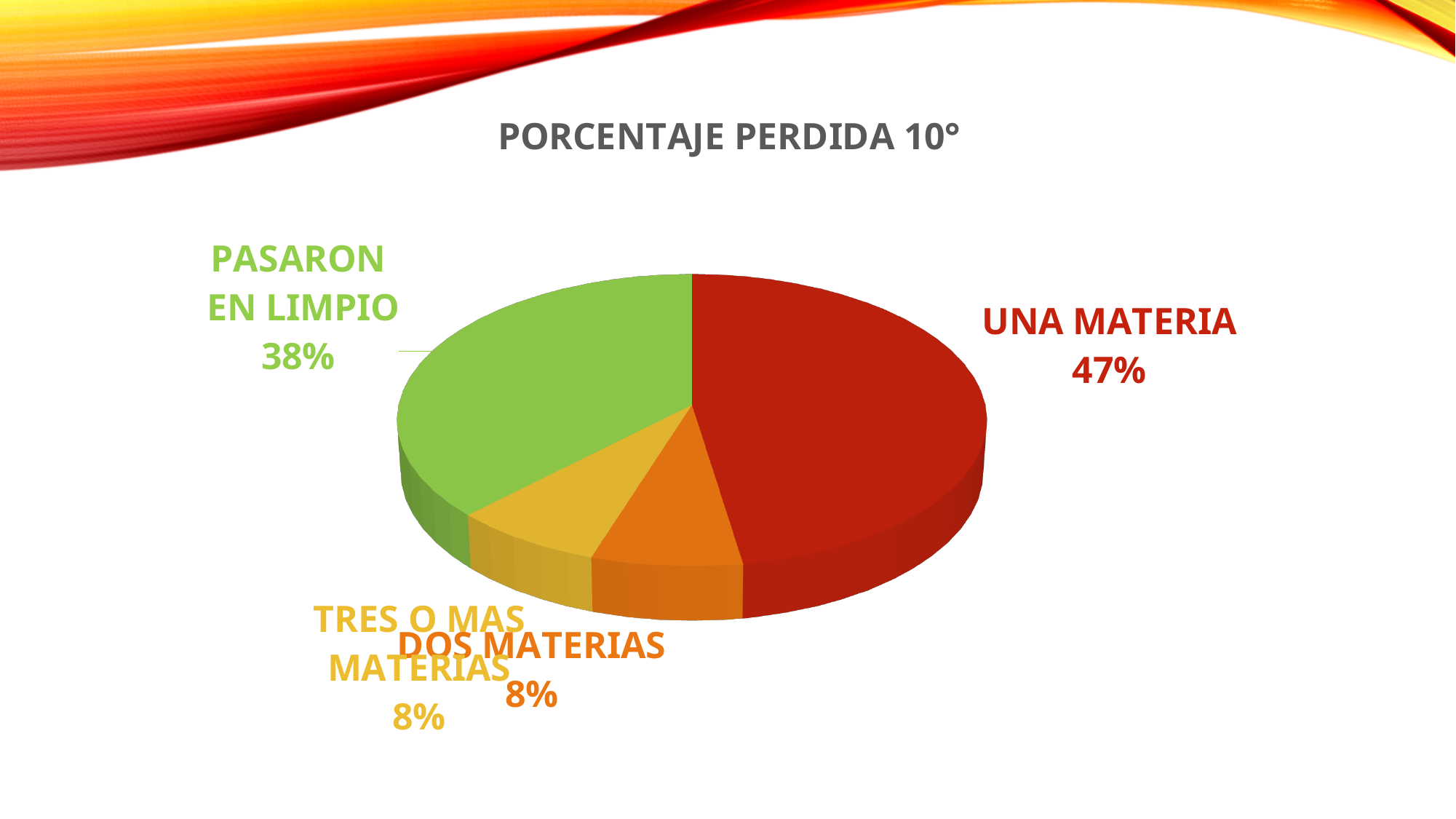
What percentage is shown for UNA MATERIA? 47% What is the title of the chart? PORCENTAJE PERDIDA 10° How many slices does the pie chart have? 4 Which category has the largest share of the pie? UNA MATERIA Which is larger, the share for PASARON EN LIMPIO or the share for DOS MATERIAS? PASARON EN LIMPIO What percentage is shown for PASARON EN LIMPIO? 38% What is the combined share of DOS MATERIAS and TRES O MAS MATERIAS? 16% What colour is the UNA MATERIA slice? red What is the difference in percentage points between UNA MATERIA and PASARON EN LIMPIO? 9 What type of chart is shown on the slide? pie chart What percentage is shown for TRES O MAS MATERIAS? 8% What percentage is shown for DOS MATERIAS? 8%